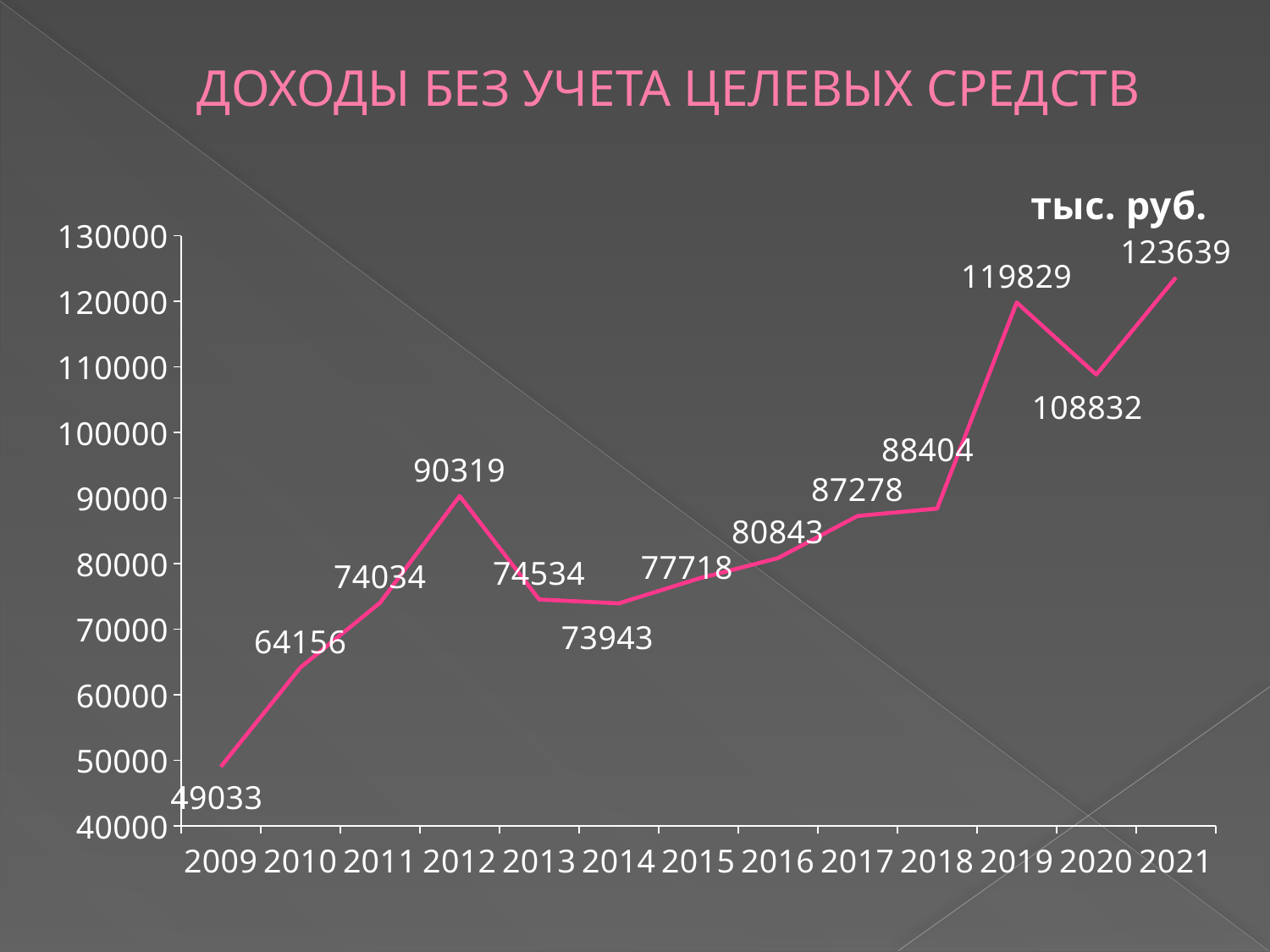
Is the value for 2019 greater or less than 110000? greater What is the value for 2012? 90319 Which year has the highest value? 2021 What type of chart is shown on the slide? line chart What is the difference between the values for 2012 and 2013? 15785 Which year has the lowest value? 2009 What unit is indicated in the top right corner of the chart? тыс. руб. What is the difference between the values for 2021 and 2020? 14807 Which is larger, the value for 2013 or the value for 2014? 2013 What is the value for 2009? 49033 What is the value for 2020? 108832 How many years are plotted on the x axis? 13